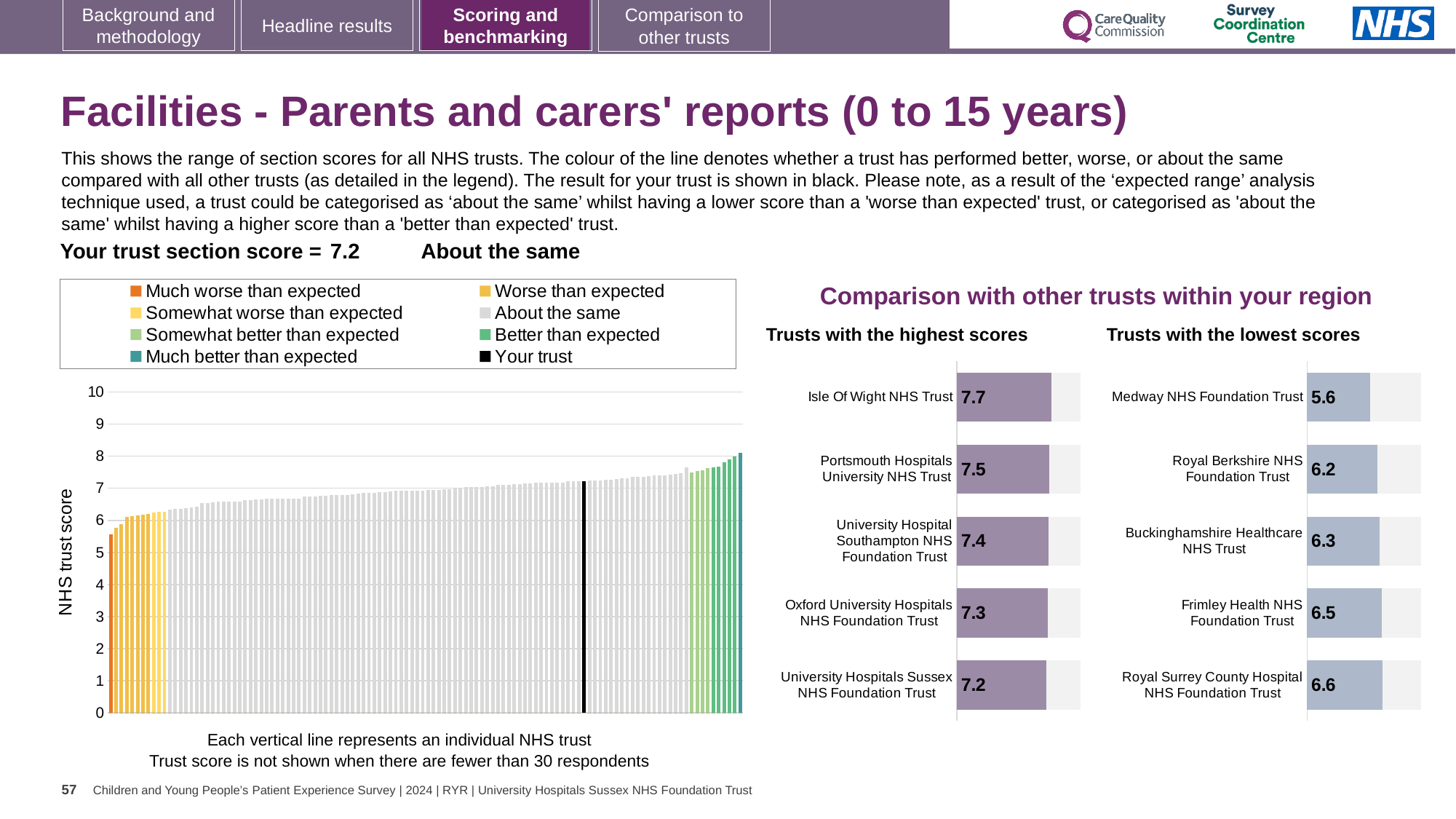
How many entries does the legend above the large chart on the left list? 8 In the 'Trusts with the highest scores' chart, what is the score for Oxford University Hospitals NHS Foundation Trust? 7.3 In the 'Trusts with the lowest scores' chart, what is the difference between the scores of Royal Surrey County Hospital NHS Foundation Trust and Medway NHS Foundation Trust? 1.0 In the 'Trusts with the lowest scores' chart, what is the score for Medway NHS Foundation Trust? 5.6 In the 'Trusts with the highest scores' chart, what is the score for Isle Of Wight NHS Trust? 7.7 In the 'Trusts with the highest scores' chart, what is the difference between the scores of Isle Of Wight NHS Trust and University Hospitals Sussex NHS Foundation Trust? 0.5 How many trusts are shown in the 'Trusts with the highest scores' chart? 5 In the 'Trusts with the lowest scores' chart, what is the score for Frimley Health NHS Foundation Trust? 6.5 In the large chart on the left showing all NHS trusts, do the trust scores rise or fall from left to right? rise In the 'Trusts with the lowest scores' chart, which has the higher score: Royal Berkshire NHS Foundation Trust or Buckinghamshire Healthcare NHS Trust? Buckinghamshire Healthcare NHS Trust In the 'Trusts with the highest scores' chart, which trust has the highest score? Isle Of Wight NHS Trust In the 'Trusts with the lowest scores' chart, which trust has the lowest score? Medway NHS Foundation Trust